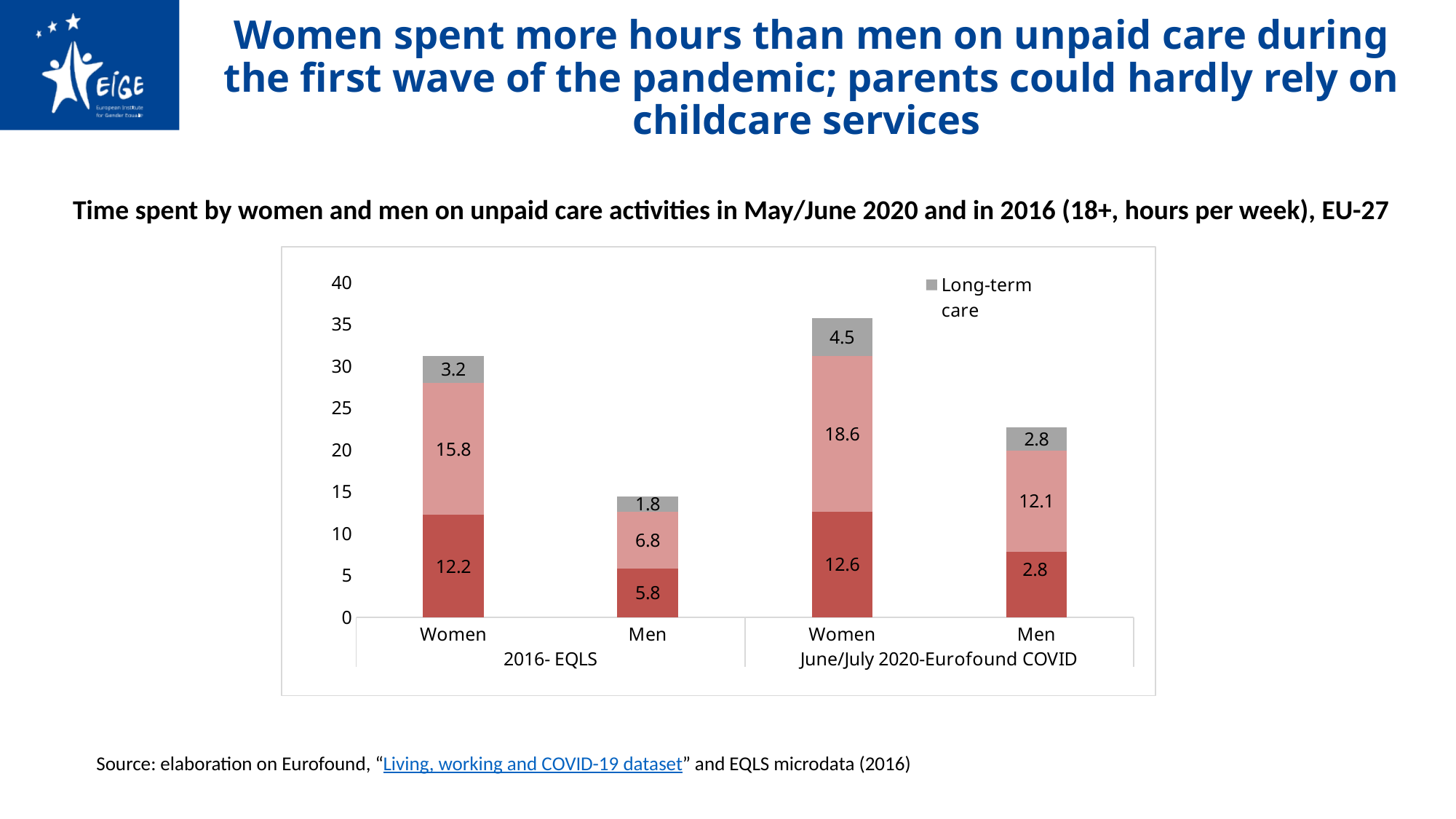
Which bar has the highest Long-term care value? Women, June/July 2020-Eurofound COVID What is the value of the middle (light pink) segment of the Women bar in the June/July 2020-Eurofound COVID group? 18.6 What is the total of the stacked bar for Women in the 2016- EQLS group? 31.2 Is the total height of the Men bar in the June/July 2020-Eurofound COVID group greater or less than 20? greater Which bar has the lowest Long-term care value? Men, 2016- EQLS What is the Long-term care value for Women in the 2016- EQLS group? 3.2 What is the Long-term care value for Men in the June/July 2020-Eurofound COVID group? 2.8 How many stacked bars are plotted in the chart? 4 In the 2016- EQLS group, which bar is taller overall, Women or Men? Women How much higher is the Long-term care value for Women in June/July 2020 than for Women in 2016? 1.3 What kind of chart is shown on the slide? Stacked bar chart